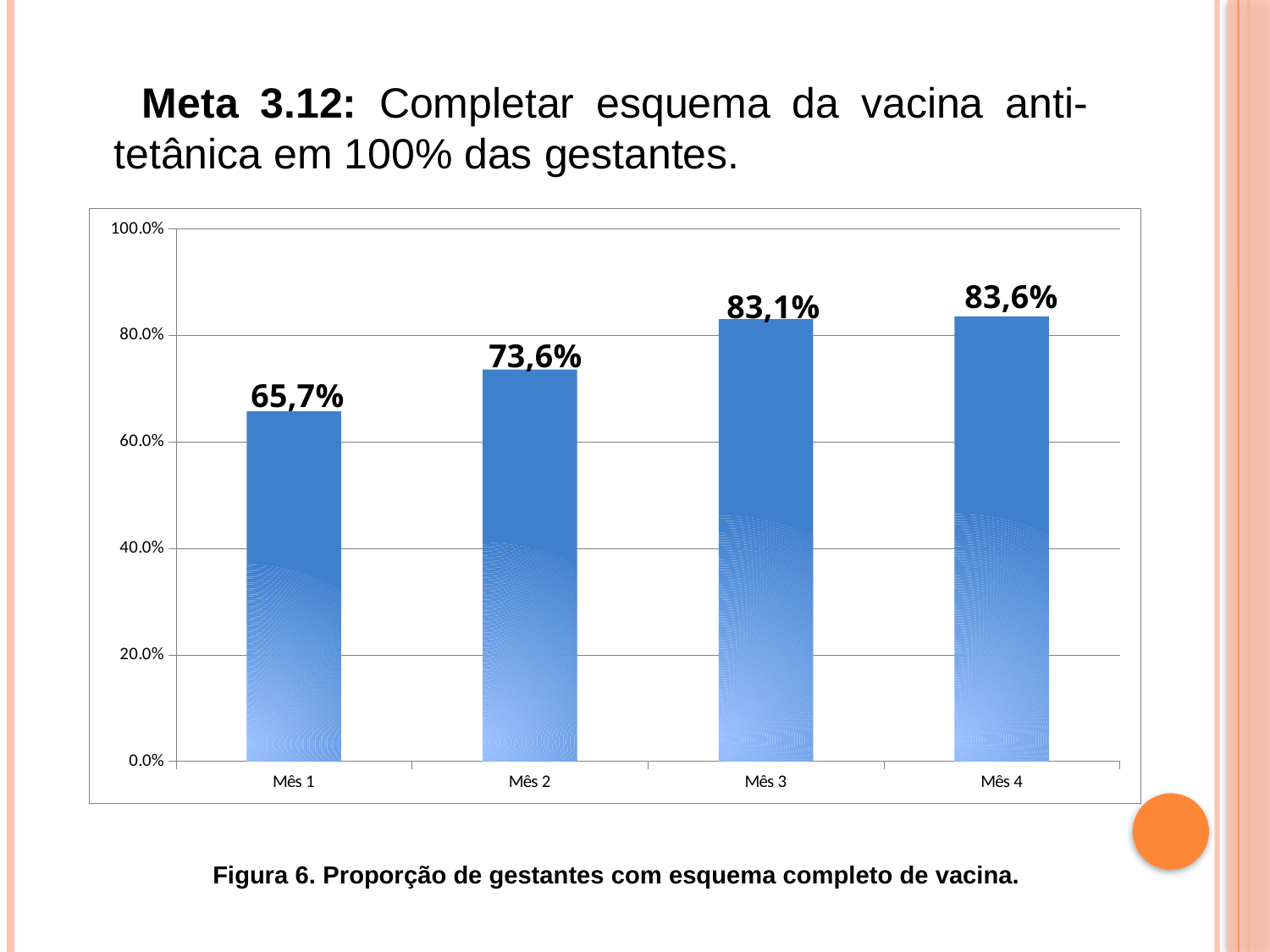
What is the value for Mês 4? 83,6% What is the value for Mês 1? 65,7% How many months are shown on the x axis? 4 Which month has the highest value? Mês 4 What is the difference between the values for Mês 2 and Mês 1? 7,9% Is the value for Mês 2 greater or less than 80.0%? less Which is larger, the value for Mês 2 or the value for Mês 3? Mês 3 Do the values rise or fall from Mês 1 to Mês 4? rise What kind of chart is shown on the slide? bar chart What is the value for Mês 3? 83,1% Which month has the lowest value? Mês 1 What is the difference between the values for Mês 4 and Mês 1? 17,9%